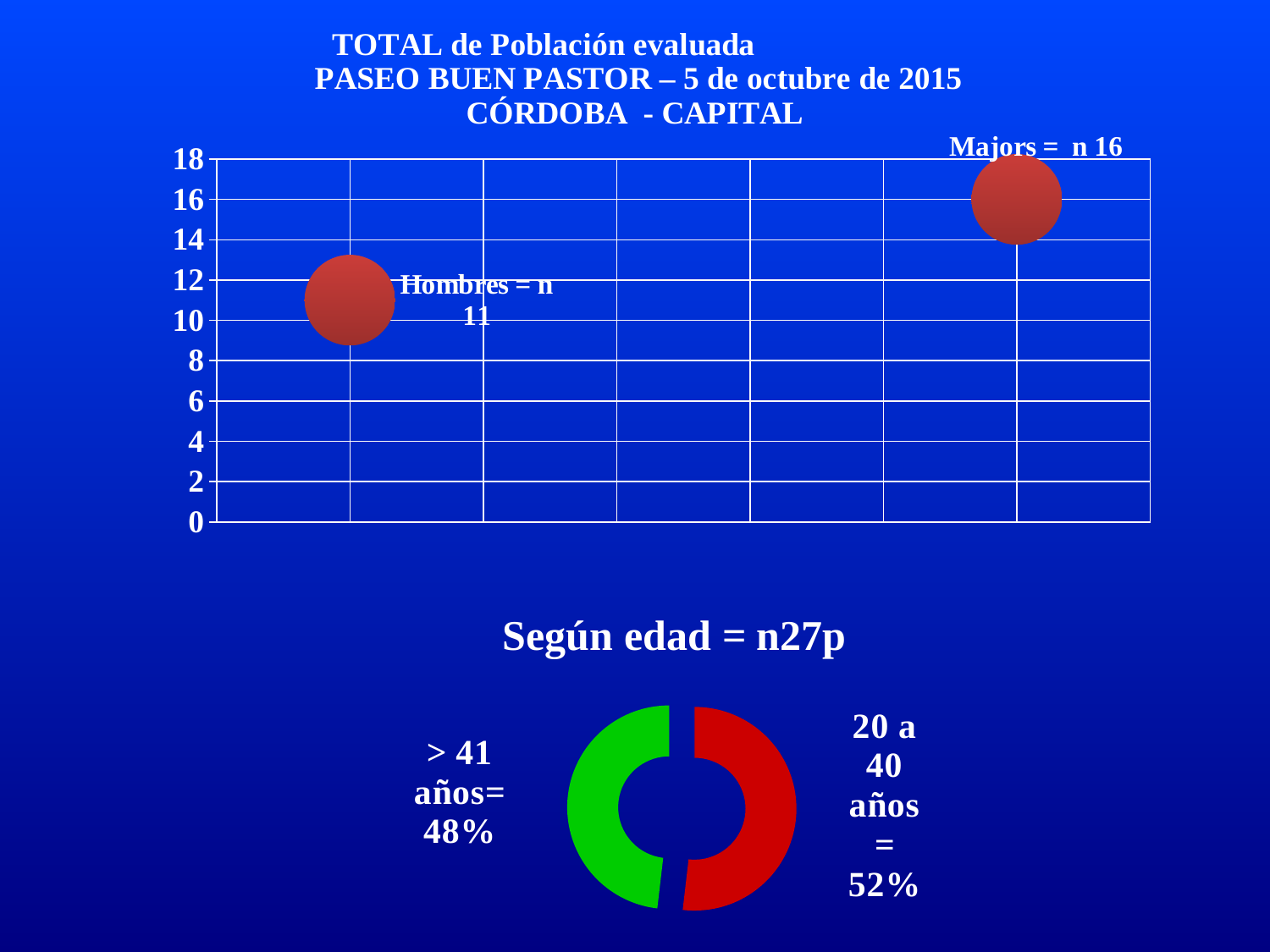
In the top chart, what is the difference between the Majors value and the Hombres value? 5 In the top chart, what is the value for Majors? 16 In the top chart, which group has the higher value, Hombres or Majors? Majors In the top chart, what is the value for Hombres? 11 In the bottom chart 'Según edad = n27p', what share is shown for 20 a 40 años? 52% In the bottom chart 'Según edad = n27p', what is the difference between the 20 a 40 años share and the > 41 años share? 4% How many data points are plotted in the top chart? 2 In the bottom chart 'Según edad = n27p', which age group has the larger share? 20 a 40 años In the bottom chart 'Según edad = n27p', which colour represents the 20 a 40 años group? Red What kind of chart is the bottom chart 'Según edad = n27p'? Doughnut chart In the bottom chart 'Según edad = n27p', what share is shown for > 41 años? 48% In the top chart, what is the maximum value shown on the vertical axis? 18